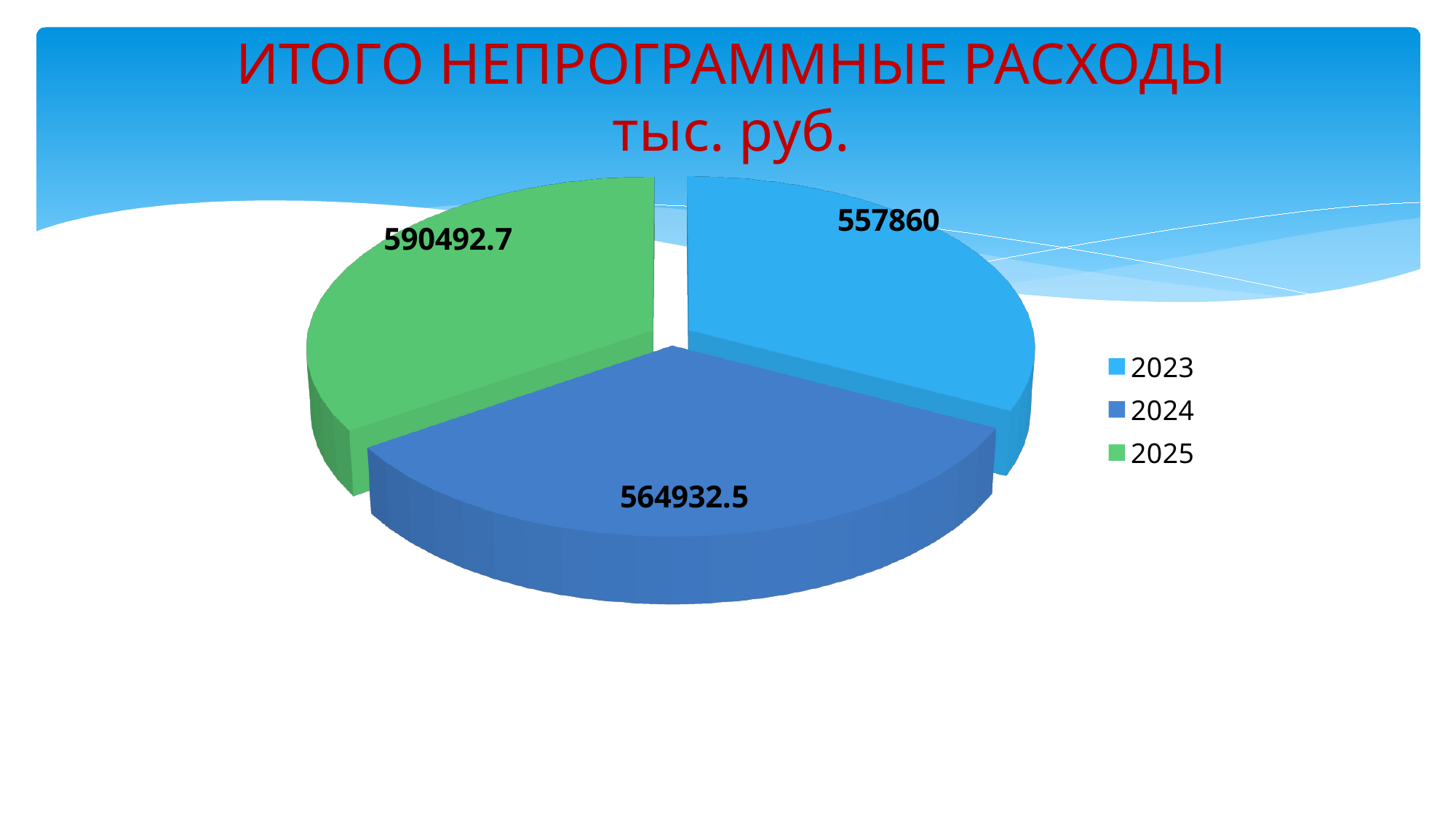
What is the value for 2024? 564932.5 How many entries does the legend list? 3 What is the difference between the values for 2024 and 2023? 7072.5 Which year has the smallest slice of the pie? 2023 What is the difference between the values for 2025 and 2023? 32632.7 What is the value for 2025? 590492.7 What is the title of the chart? ИТОГО НЕПРОГРАММНЫЕ РАСХОДЫ тыс. руб. Which year has the largest slice of the pie? 2025 How many slices does the pie chart have? 3 What kind of chart is shown on the slide? Pie chart Which is larger, the value for 2024 or the value for 2025? 2025 What is the value for 2023? 557860